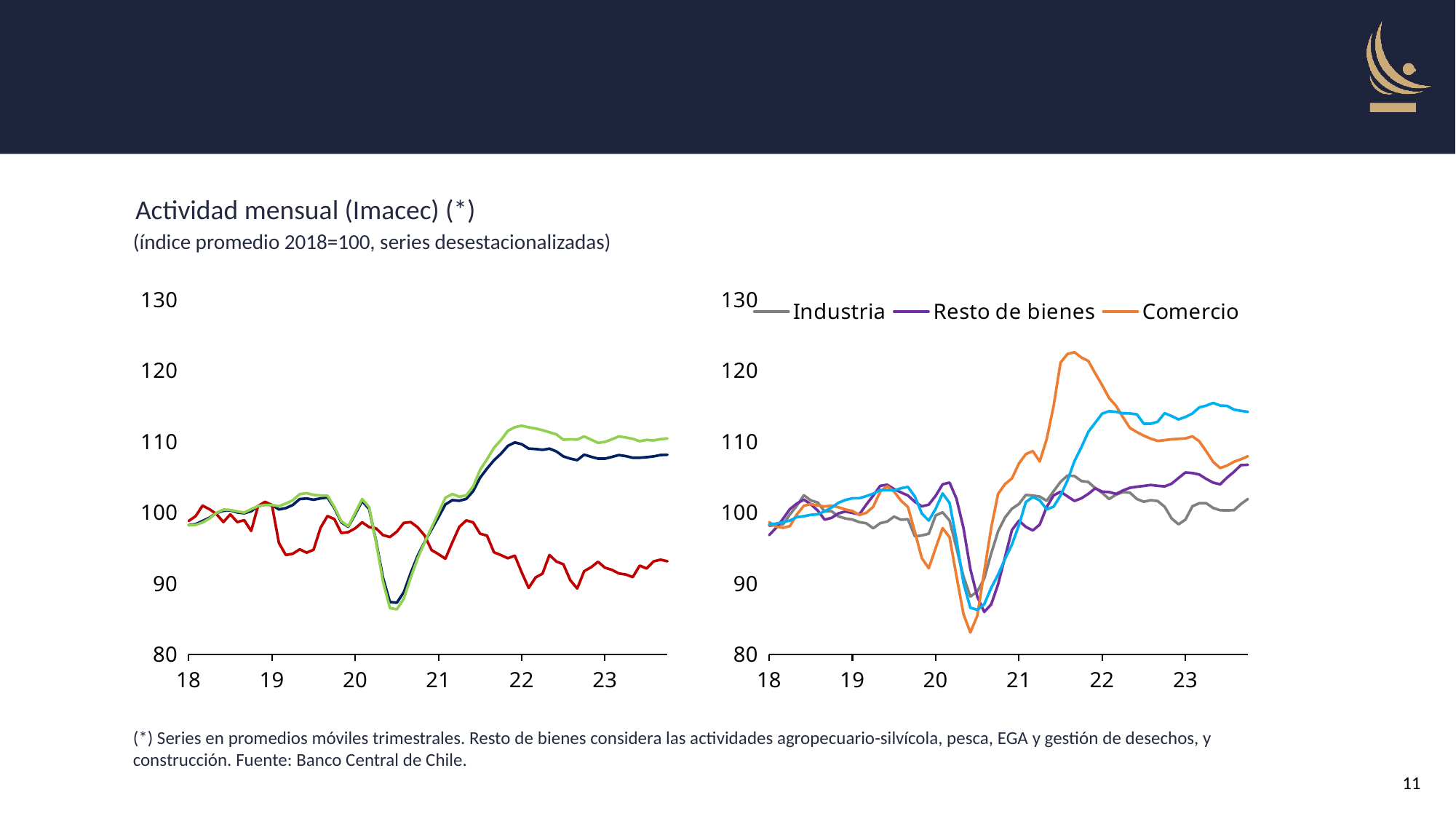
How many series does the legend of the right-hand chart list? 3 In the right-hand chart, is the value of Resto de bienes at the end of 2023 greater or less than 100? greater In the right-hand chart, is the lowest value of Industria in 2020 greater or less than 90? less In the right-hand chart, does Comercio rise or fall between 2022 and 2023? fall What is the title of the slide's chart? Actividad mensual (Imacec) (*) In the right-hand chart, is the lowest value of Comercio in 2020 greater or less than 90? less Which series are named in the legend of the right-hand chart? Industria, Resto de bienes, Comercio What kind of chart is the right-hand chart on the slide? line chart In the right-hand chart, which series reaches the highest peak over the whole period? Comercio How many lines are plotted in the left-hand chart? 3 In the right-hand chart, which series is higher at the end of 2023, Comercio or Industria? Comercio